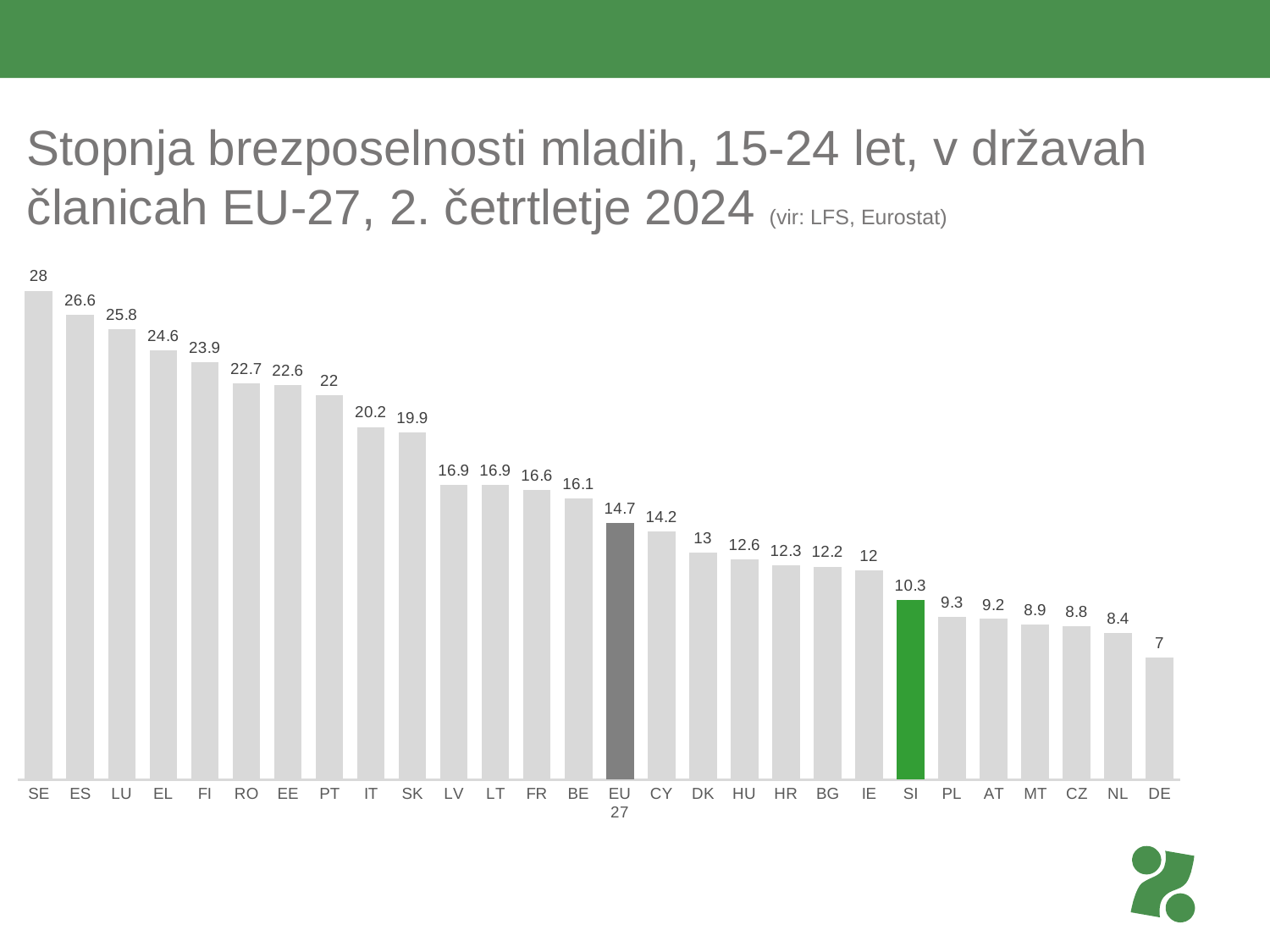
Which country has the highest youth unemployment rate on the chart? SE Which country has the lowest youth unemployment rate on the chart? DE How many bars are shown on the chart? 28 What is the difference between the values for SE and DE? 21 What is the difference between the EU 27 value and the SI value? 4.4 Which has a higher value, CY or DK? CY What is the value for FR? 16.6 What is the value for EU 27? 14.7 Which has a higher value, ES or LU? ES Which bar is highlighted in green? SI What kind of chart is shown on the slide? Bar chart What is the value for SI (Slovenia)? 10.3